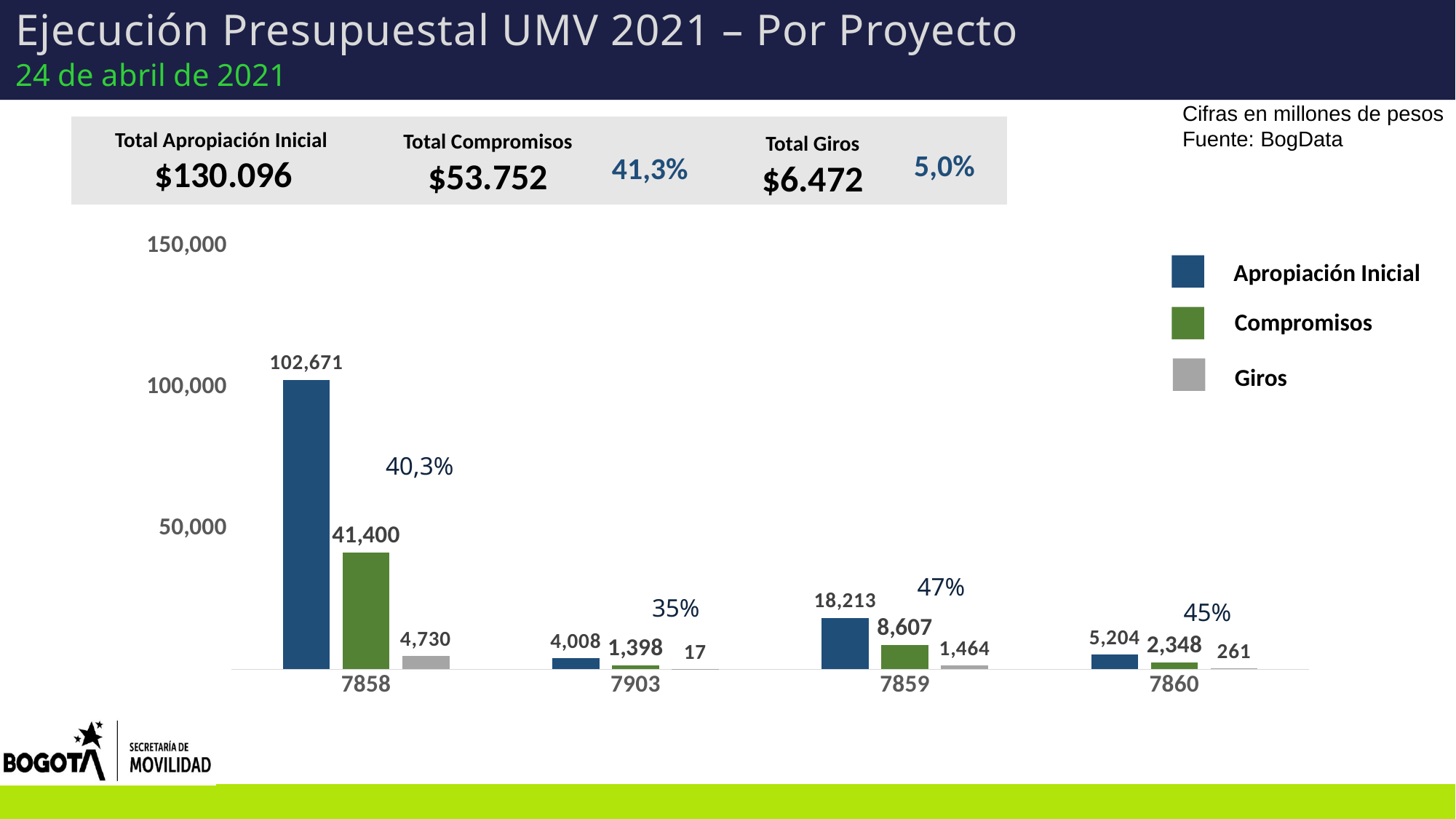
How many series does the chart legend list? 3 How many projects are shown on the x axis of the chart? 4 Which is larger, the Apropiación Inicial for project 7860 or for project 7903? 7860 What is the Giros value for project 7860? 261 What is the difference between Apropiación Inicial and Compromisos for project 7858? 61,271 What is the Compromisos value for project 7859? 8,607 What is the Apropiación Inicial value for project 7858? 102,671 Is the Apropiación Inicial value for project 7858 greater or less than 100,000? greater What is the Giros value for project 7903? 17 Which project has the lowest Compromisos value? 7903 Which project has the highest Apropiación Inicial? 7858 What kind of chart is shown on the slide? bar chart